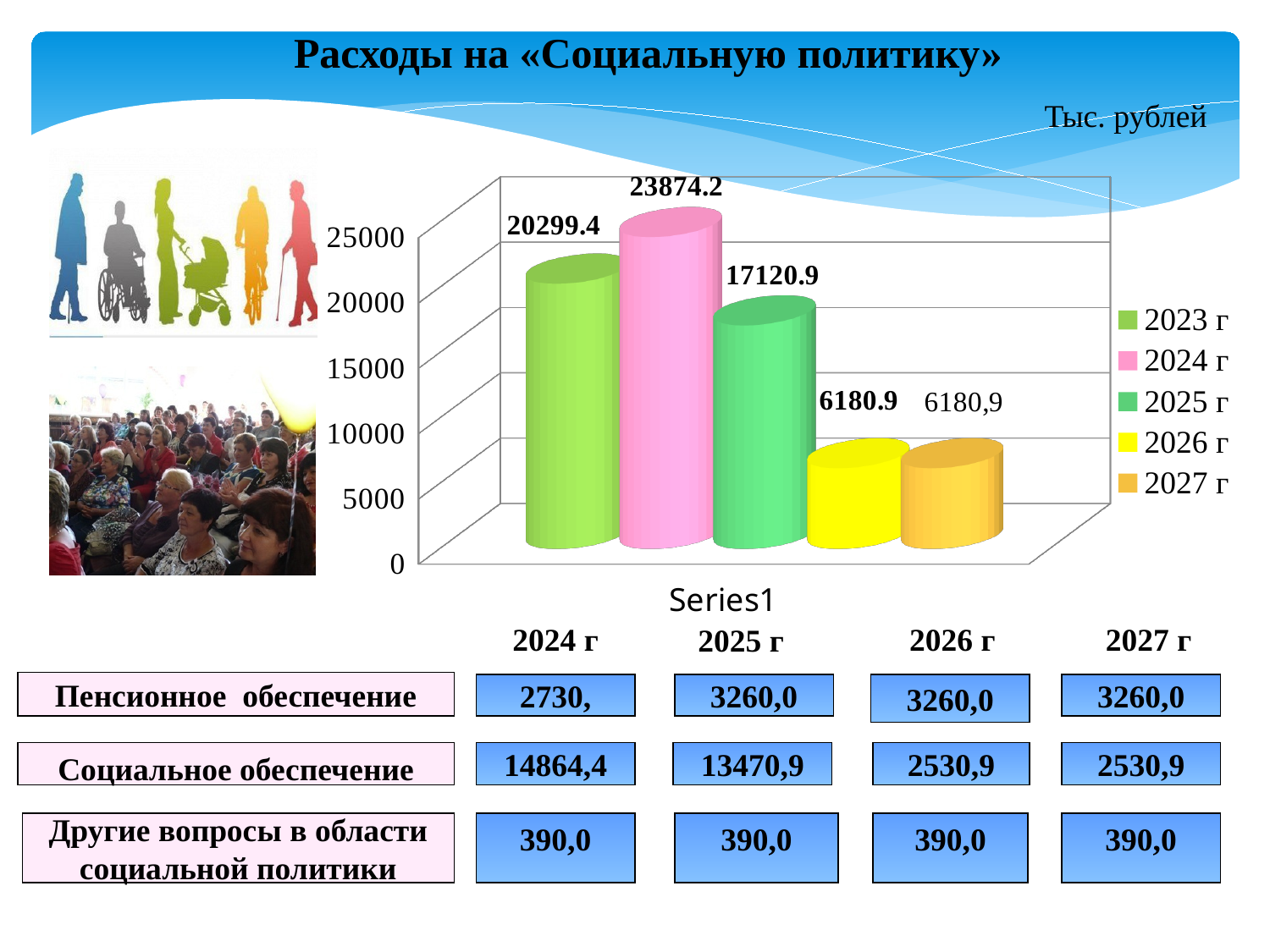
Is the value for 2025 г greater or less than 20000? less What is the value for 2023 г in the chart? 20299.4 Which is larger, the value for 2025 г or the value for 2026 г? 2025 г How many entries does the chart legend list? 5 What is the value for 2024 г in the chart? 23874.2 What is the value for 2025 г in the chart? 17120.9 What type of chart is shown on the slide? bar chart What is the difference between the values for 2023 г and 2025 г? 3178.5 Which year has the highest value in the chart? 2024 г What is the difference between the values for 2024 г and 2023 г? 3574.8 How many bars are plotted in the chart? 5 What is the value for 2026 г in the chart? 6180.9